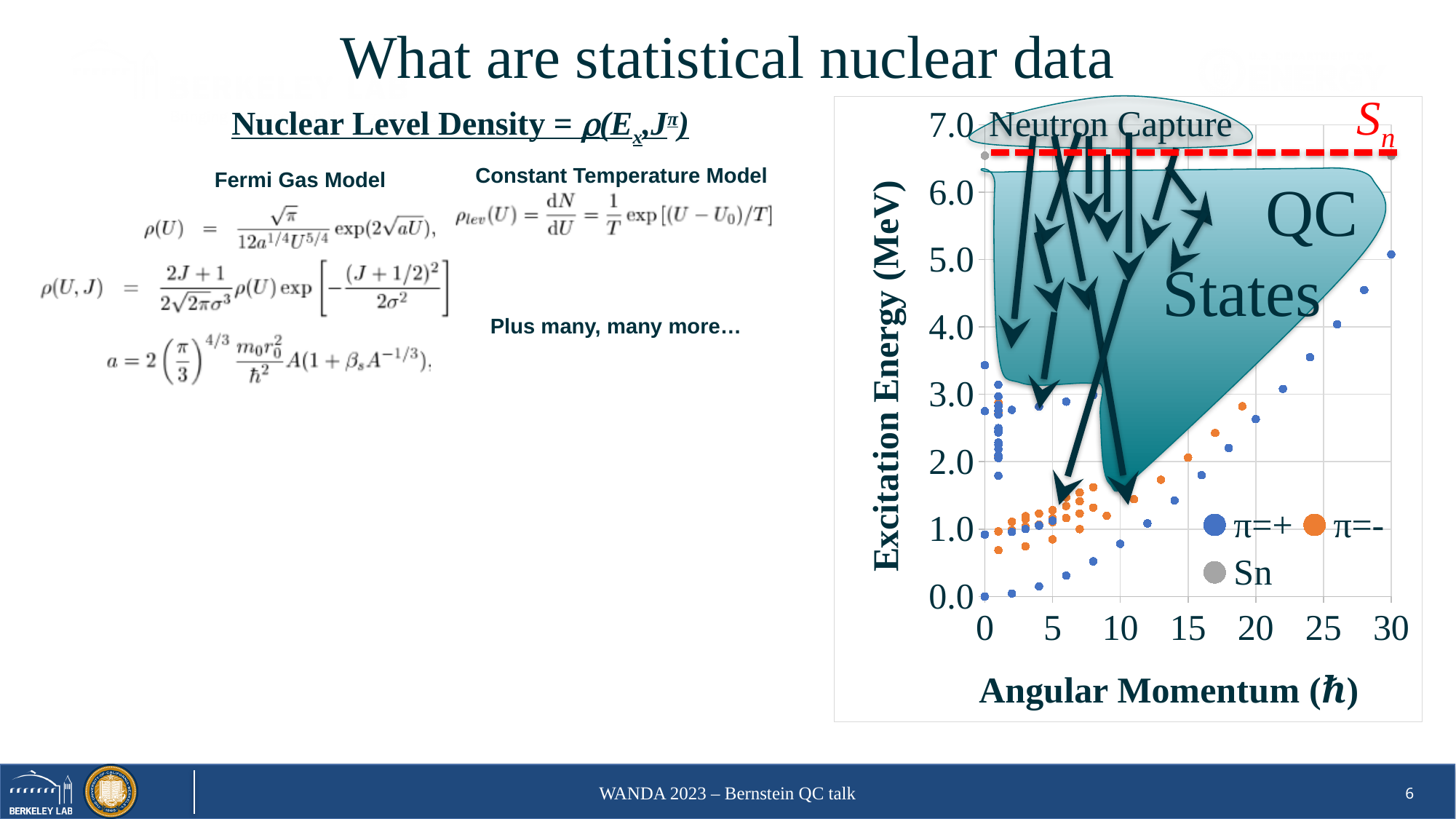
What kind of chart is shown on the right of the slide? scatter plot Is the excitation energy of the Sn points (the dashed red line) greater or less than 6.0 MeV? greater Is the excitation energy of the π=+ point at angular momentum 30 greater or less than 4.0 MeV? greater How many series does the legend of the scatter plot list? 3 Which series in the scatter plot is drawn in orange? π=- Is the excitation energy of the Sn points (the dashed red line) greater or less than 7.0 MeV? less What is the x-axis label of the scatter plot? Angular Momentum (ℏ) Does the upper edge of the plotted π=+ points rise or fall as angular momentum increases from 10 to 30? rise